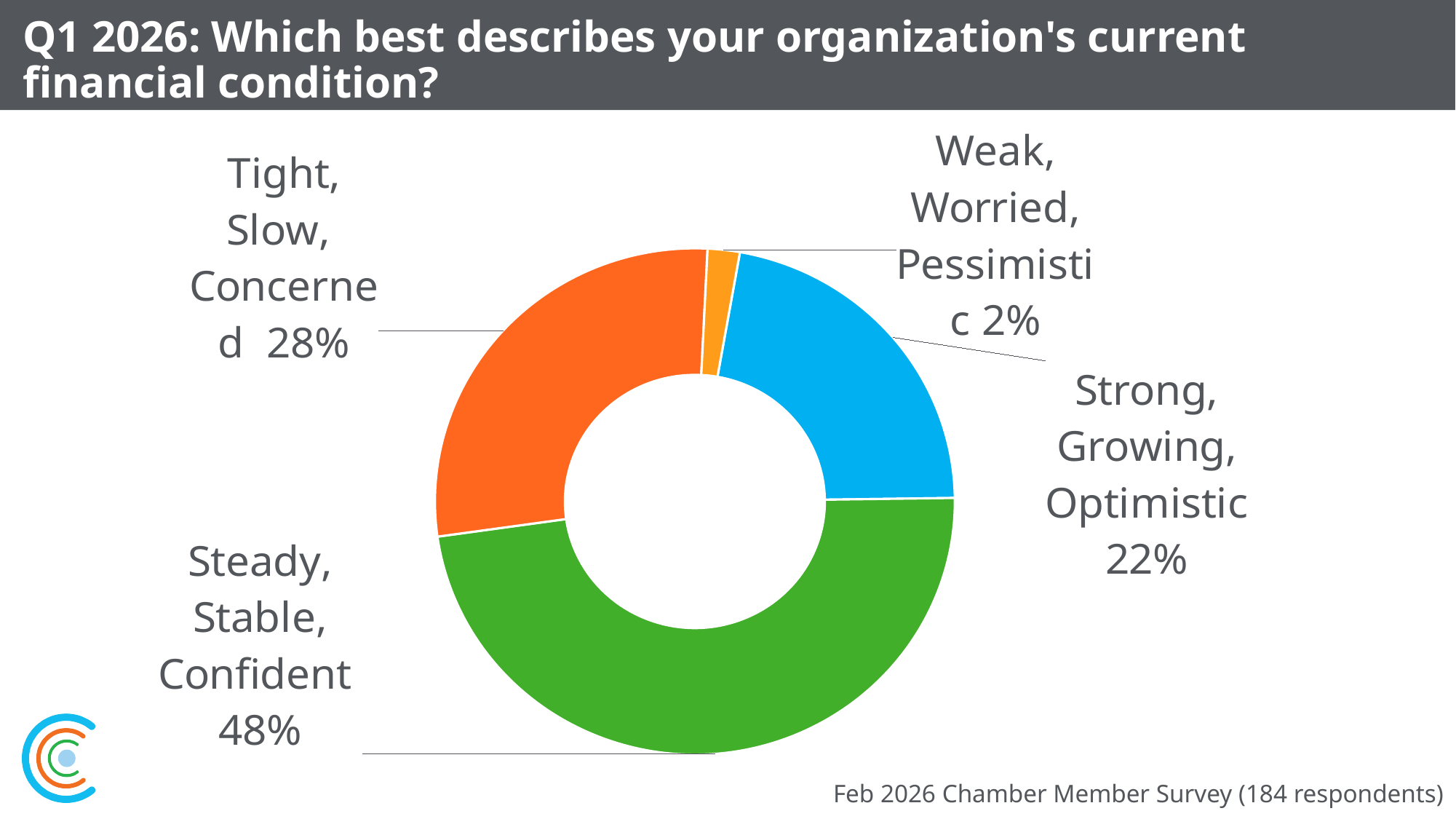
What share of respondents selected Strong, Growing, Optimistic? 22% What percentage of respondents described their financial condition as Weak, Worried, Pessimistic? 2% What kind of chart is shown on the slide? Pie chart (doughnut) What percentage of respondents chose Tight, Slow, Concerned? 28% How many respondents took part in the survey, according to the note on the slide? 184 Which category has the smallest share of the chart? Weak, Worried, Pessimistic How many categories are shown in the chart? 4 Which is larger: the share for Strong, Growing, Optimistic or the share for Tight, Slow, Concerned? Tight, Slow, Concerned What is the difference in percentage points between Tight, Slow, Concerned and Strong, Growing, Optimistic? 6 What is the difference in percentage points between Steady, Stable, Confident and Tight, Slow, Concerned? 20 Which category has the largest share of the chart? Steady, Stable, Confident What percentage of respondents described their organization's financial condition as Steady, Stable, Confident? 48%